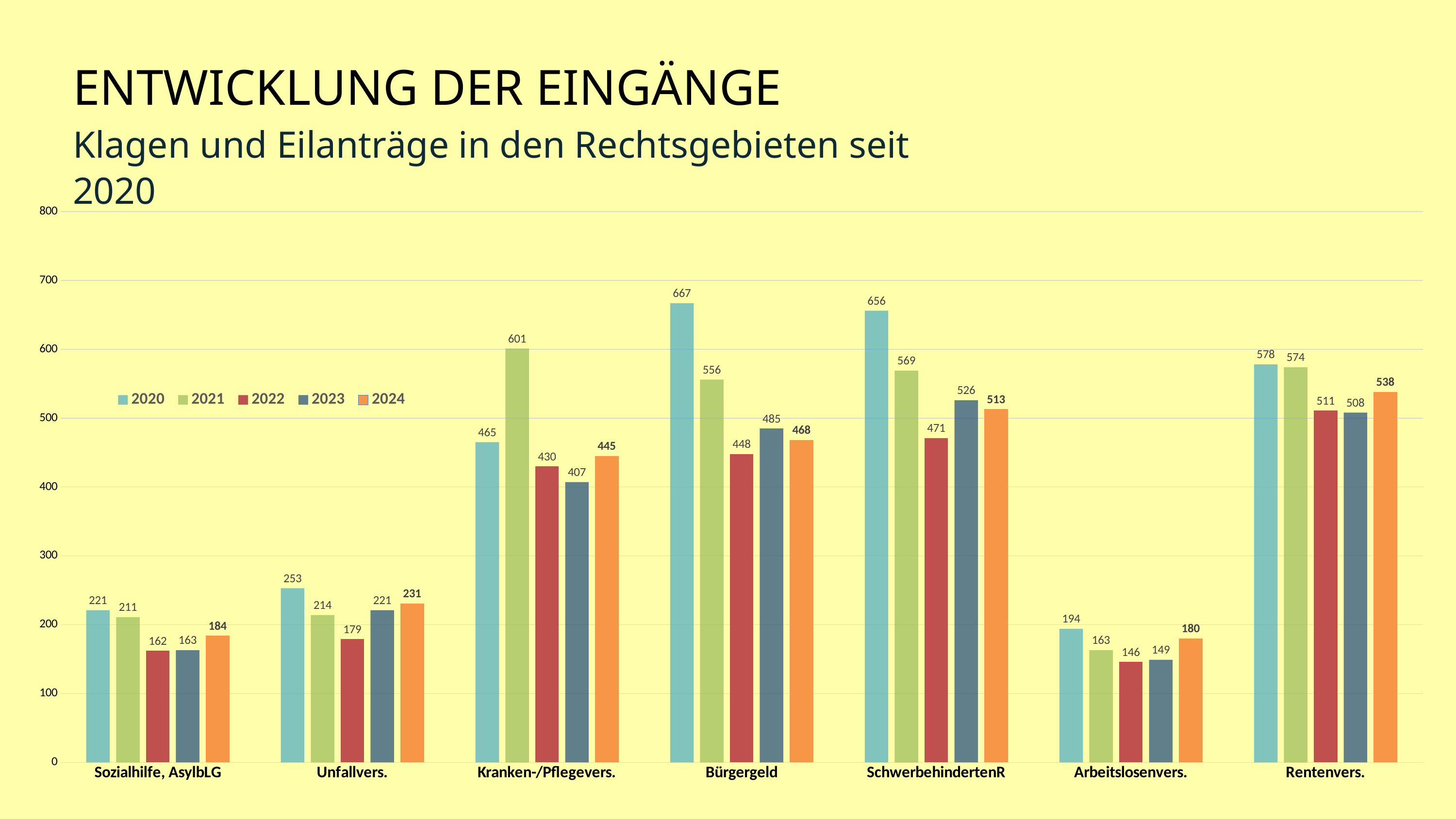
What is the subtitle of the chart? Klagen und Eilanträge in den Rechtsgebieten seit 2020 What kind of chart is shown on the slide? Bar chart How many categories are shown on the x axis? 7 Which category has the highest value in 2021? Kranken-/Pflegevers. What is the value for Bürgergeld in 2020? 667 Which category has the lowest value in 2023? Arbeitslosenvers. What is the value for Rentenvers. in 2024? 538 What is the value for Arbeitslosenvers. in 2022? 146 Is the 2021 value for Kranken-/Pflegevers. greater or less than 500? greater Which is larger: the 2023 value for Unfallvers. or the 2023 value for Sozialhilfe, AsylbLG? Unfallvers. What is the difference between the 2020 and 2024 values for Schwerbehindertenr? 143 How many series does the legend list? 5